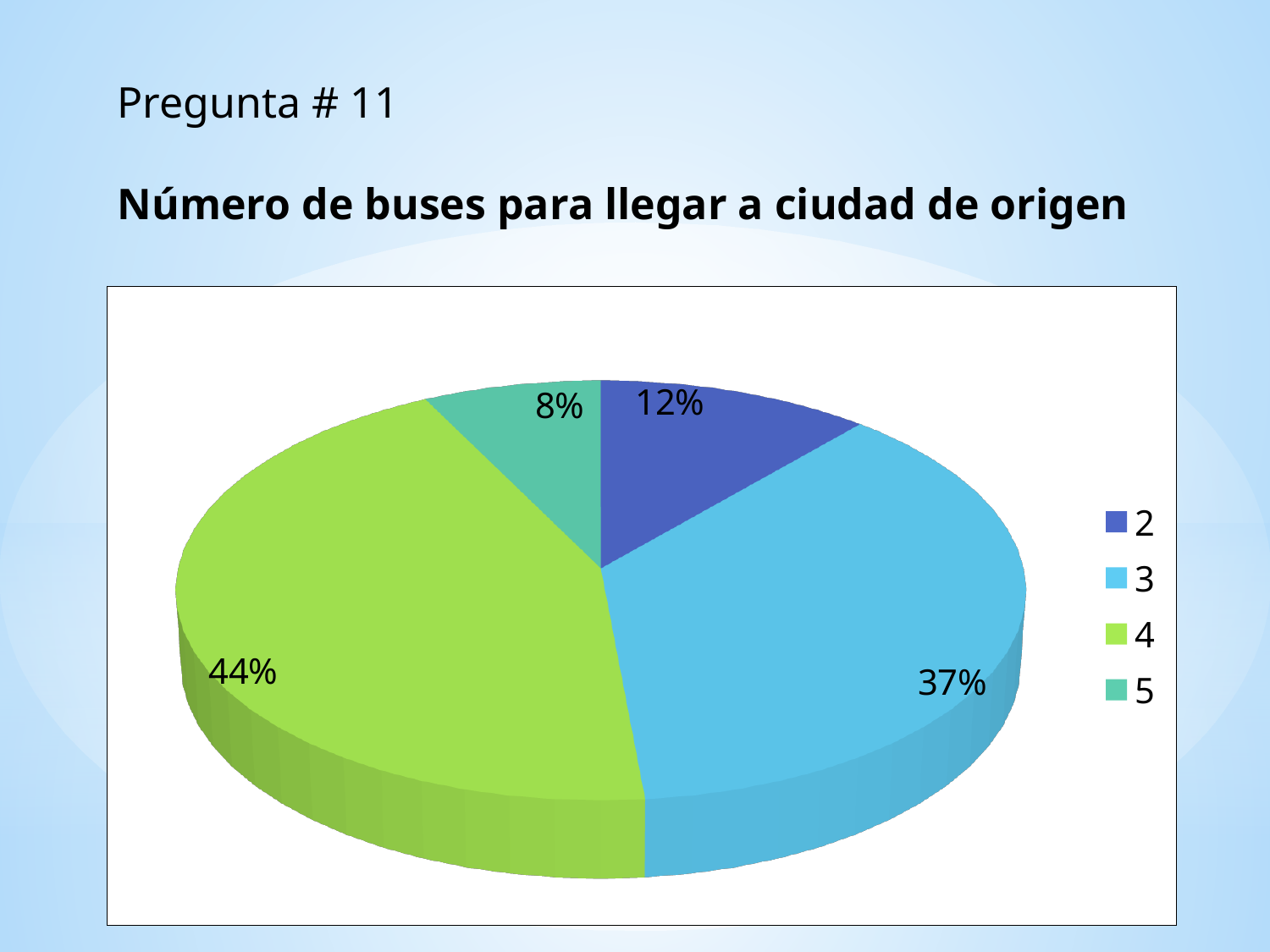
What share of the pie does category 5 have? 8% What kind of chart is shown on the slide? pie chart What is the difference in percentage points between category 4 and category 3? 7 Which has a larger share, category 2 or category 3? 3 What is the difference in percentage points between category 2 and category 5? 4 What share of the pie does category 4 have? 44% Which category has the smallest slice of the pie? 5 What share of the pie does category 2 have? 12% Which category has the largest slice of the pie? 4 How many categories does the pie chart show? 4 What is the title of the chart on the slide? Número de buses para llegar a ciudad de origen